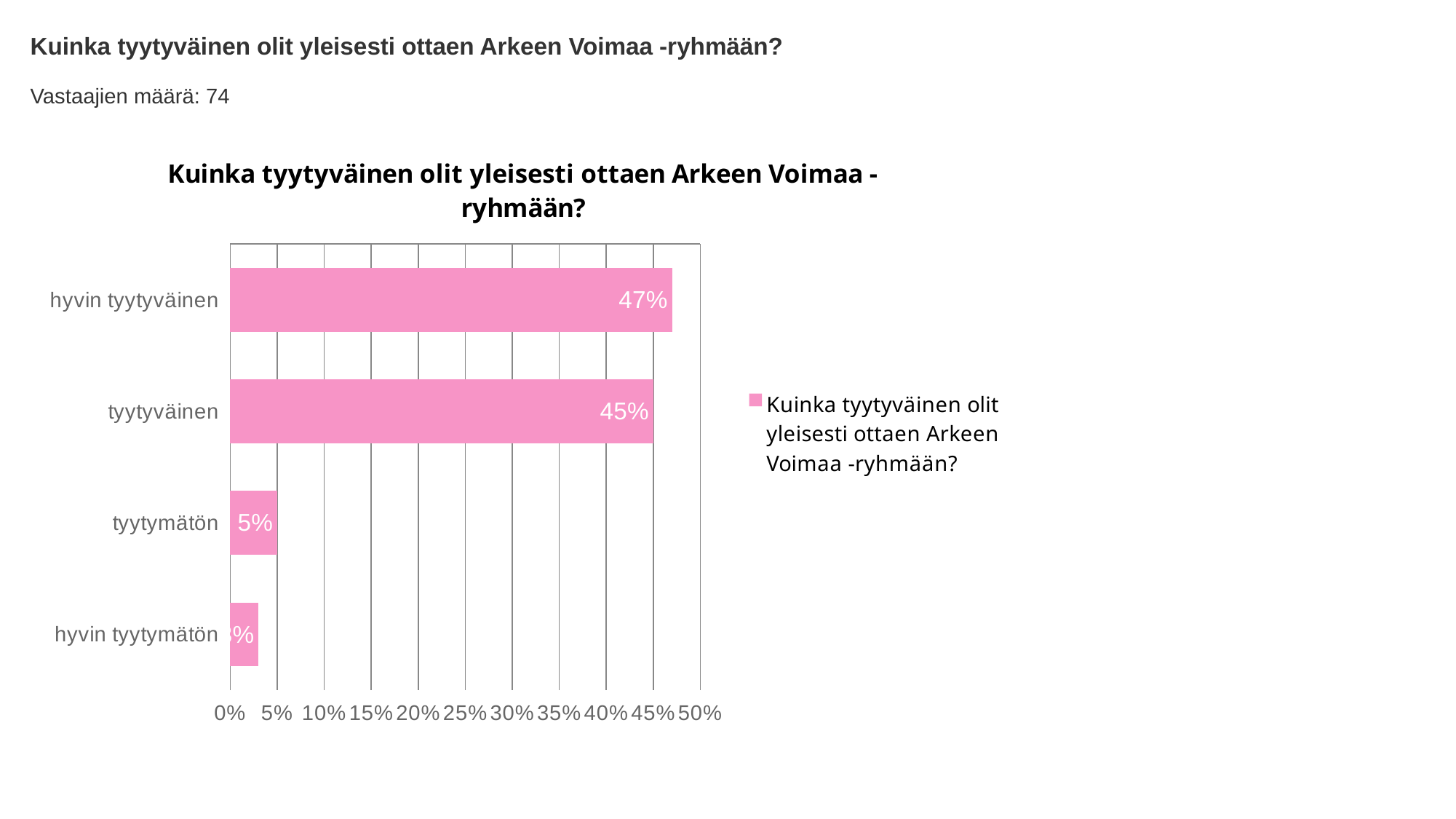
What kind of chart is shown on the slide? bar chart What is the value for hyvin tyytyväinen? 47% What is the difference between the values for tyytyväinen and tyytymätön? 40% How many categories are shown in the chart? 4 What is the value for tyytymätön? 5% Which category has the highest value? hyvin tyytyväinen Which is larger, the value for tyytyväinen or the value for tyytymätön? tyytyväinen What is the difference between the values for hyvin tyytyväinen and tyytyväinen? 2% Is the value for hyvin tyytymätön greater or less than 5%? less Which category has the lowest value? hyvin tyytymätön What is the value for tyytyväinen? 45% How many series does the legend list? 1